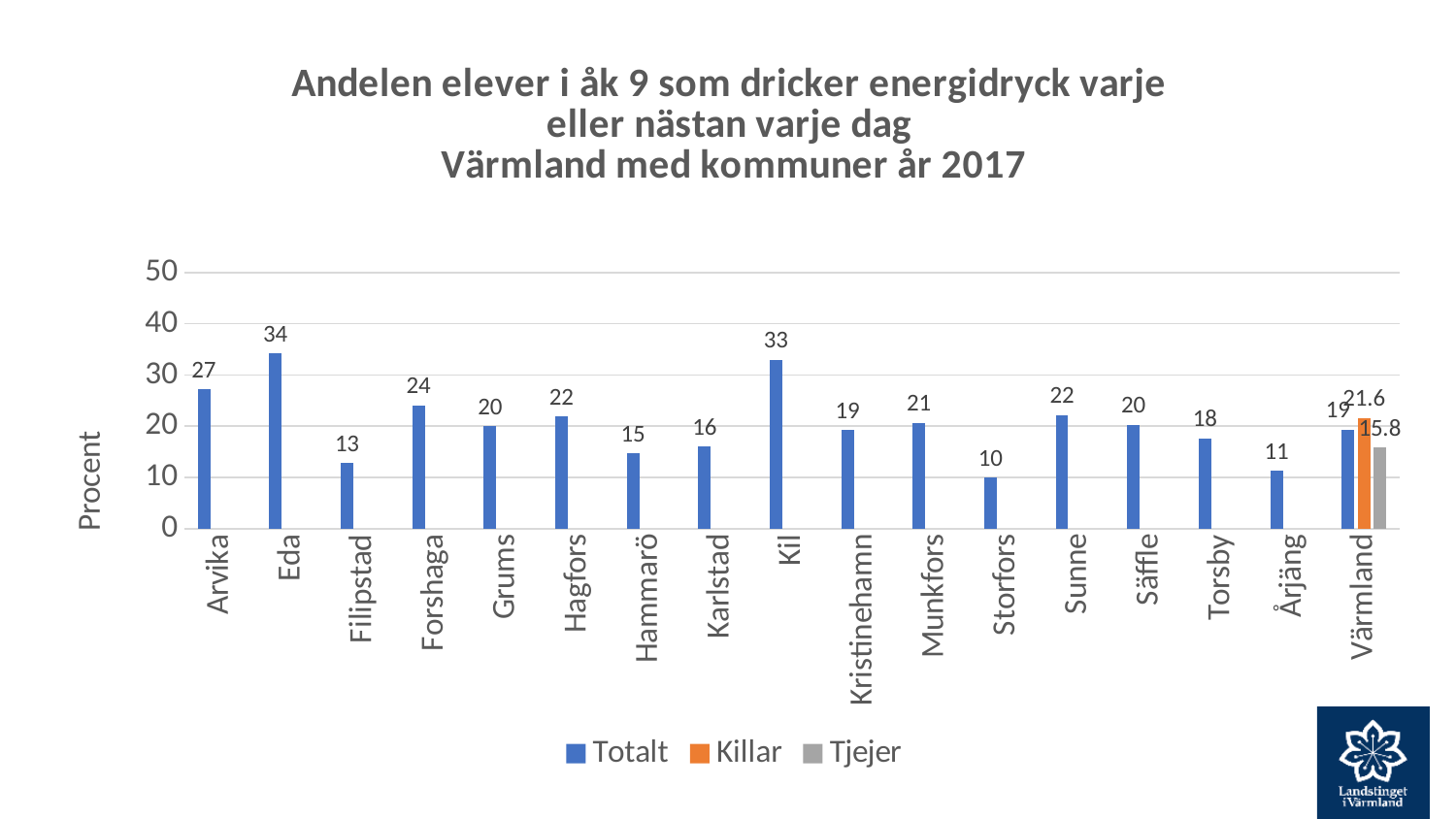
What is the Totalt value for Eda? 34 What is the Tjejer value for Värmland? 15.8 What is the Totalt value for Storfors? 10 What is the difference between the Killar and Tjejer values for Värmland? 5.8 What is the difference between the Totalt values for Eda and Kil? 1 What is the Killar value for Värmland? 21.6 How many series does the legend list? 3 What kind of chart is shown on the slide? Bar chart Which municipality has the lowest Totalt value? Storfors How many categories are shown on the x axis? 17 Which has a larger Totalt value, Arvika or Forshaga? Arvika Which municipality has the highest Totalt value? Eda